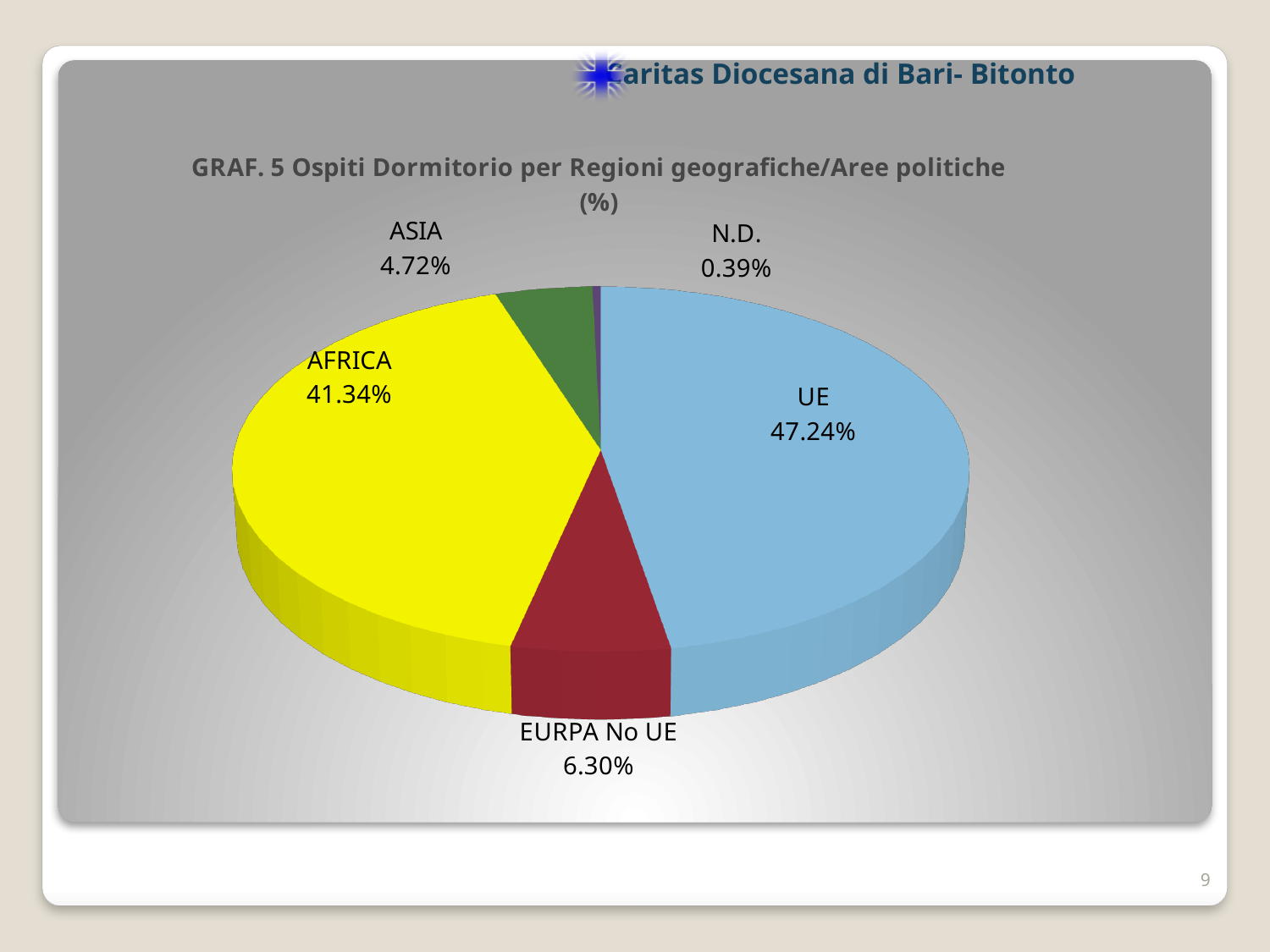
What is the percentage for ASIA? 4.72% Which is larger, the share for EURPA No UE or the share for ASIA? EURPA No UE What is the percentage for UE? 47.24% What is the difference in percentage points between UE and AFRICA? 5.90% What is the title of the chart? GRAF. 5 Ospiti Dormitorio per Regioni geografiche/Aree politiche (%) What is the percentage for N.D.? 0.39% What type of chart is shown on the slide? Pie chart What is the percentage for AFRICA? 41.34% Which category has the smallest share of the pie? N.D. What is the percentage for EURPA No UE? 6.30% Which category has the largest share of the pie? UE How many categories are shown in the pie chart? 5